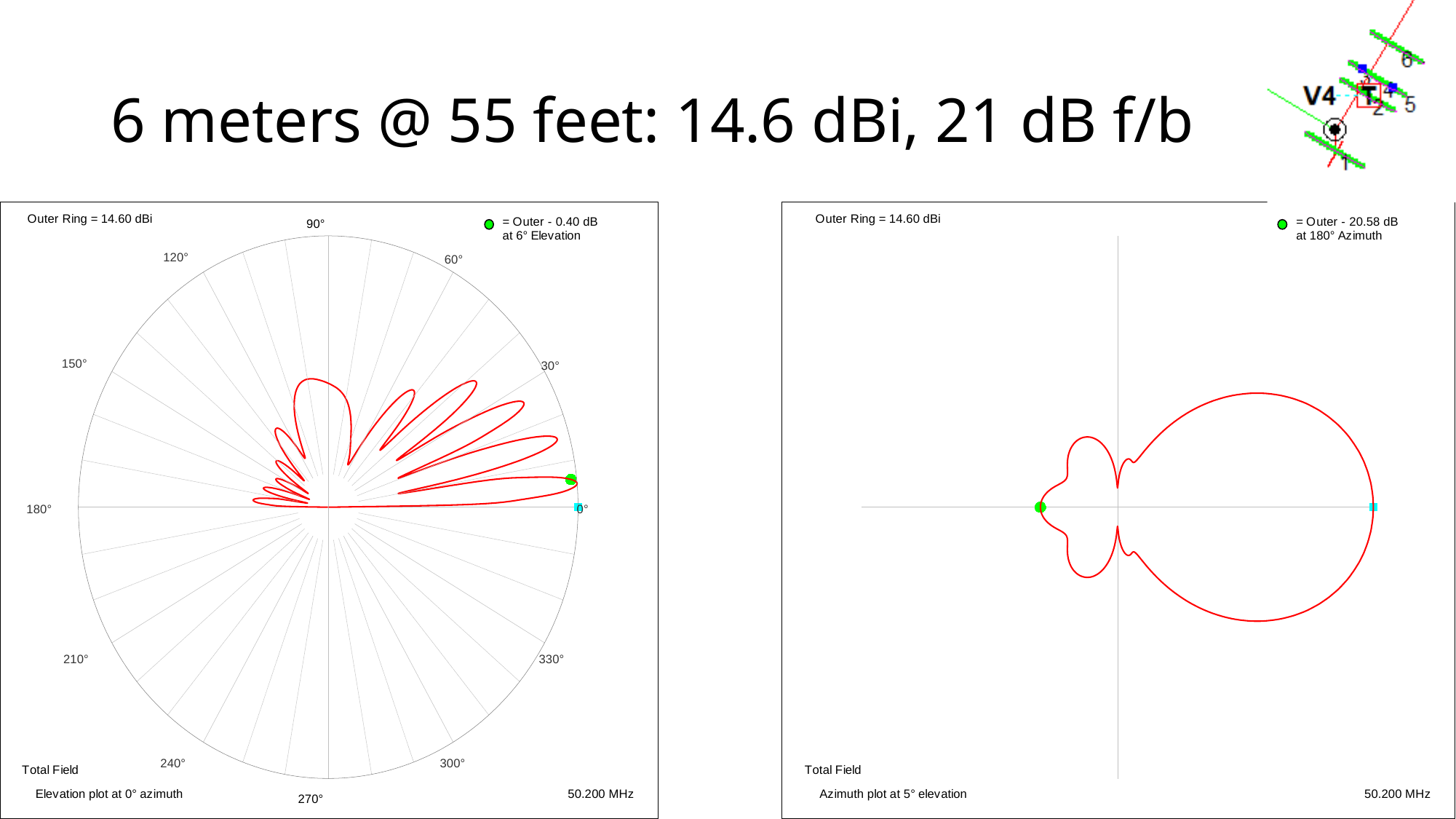
On the right chart (Azimuth plot at 5° elevation), what is the value of the outer ring? 14.60 dBi On the left chart (Elevation plot at 0° azimuth), at what elevation angle is the marked point located? 6° On the right chart (Azimuth plot at 5° elevation), at what azimuth is the marked point located? 180° On the right chart (Azimuth plot at 5° elevation), how far below the outer ring is the marked point? 20.58 dB On the left chart (Elevation plot at 0° azimuth), what is the value of the outer ring? 14.60 dBi How many charts are shown on the slide? 2 What frequency is shown on the left chart (Elevation plot at 0° azimuth)? 50.200 MHz What is the title of the slide? 6 meters @ 55 feet: 14.6 dBi, 21 dB f/b What is the difference between the marked point offsets on the right chart (20.58 dB) and the left chart (0.40 dB)? 20.18 dB On the left chart (Elevation plot at 0° azimuth), how far below the outer ring is the marked point? 0.40 dB Which chart's marked point is further below the outer ring: the left elevation plot or the right azimuth plot? the right azimuth plot What kind of chart is the left chart (Elevation plot at 0° azimuth)? polar (radar) chart